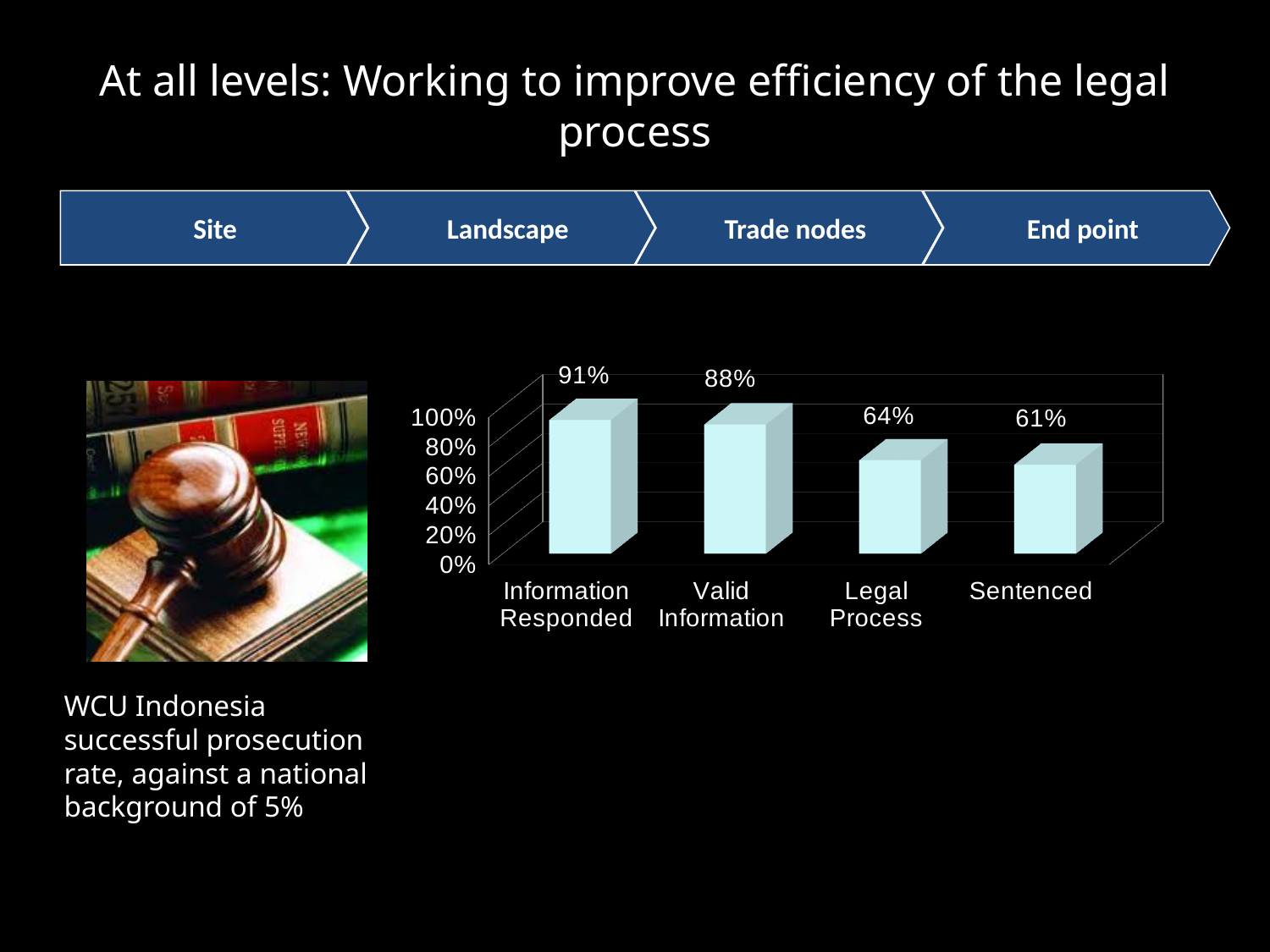
What is the value for Legal Process? 64% What is the difference between the values for Valid Information and Legal Process? 24% What is the value for Information Responded? 91% Which category has the lowest value? Sentenced Which category has the highest value? Information Responded What kind of chart is shown on the slide? Bar chart What is the value for Sentenced? 61% Which is larger, the value for Valid Information or the value for Legal Process? Valid Information What is the difference between the values for Information Responded and Sentenced? 30% What is the value for Valid Information? 88% Do the values rise or fall from left to right along the x axis? Fall How many categories are shown on the x axis of the chart? 4